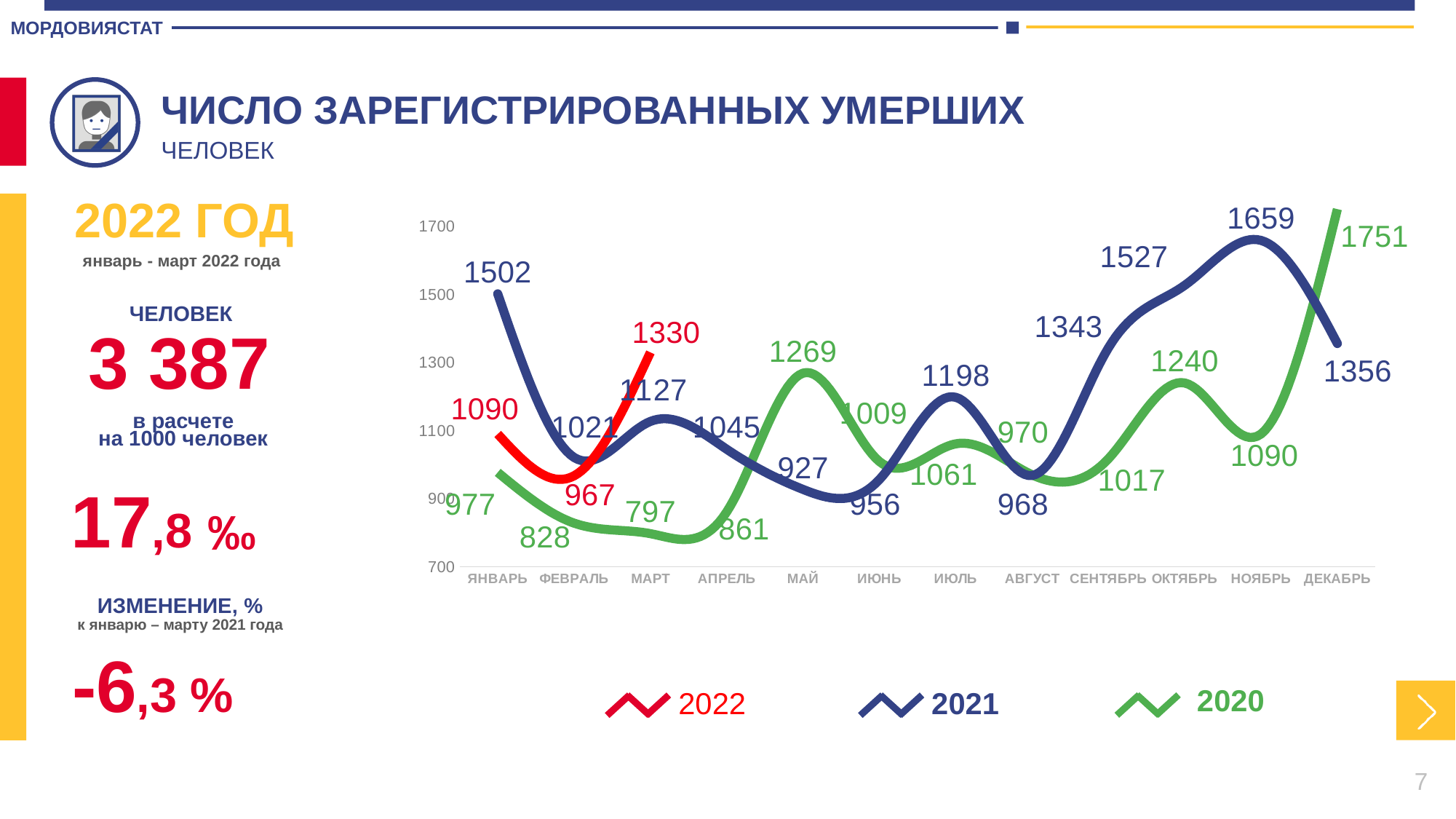
In which month does the 2021 series reach its highest value? НОЯБРЬ What is the value for March 2022 (МАРТ, 2022 series)? 1330 How many months are shown on the x axis of the chart? 12 In which month does the 2020 series have its lowest value? МАРТ How many series does the chart legend list? 3 Which series has the larger value in May (МАЙ): 2021 or 2020? 2020 What is the value for December 2020 (ДЕКАБРЬ, 2020 series)? 1751 What kind of chart is shown on the slide? line chart What is the difference between the 2021 values for November and December? 303 What is the number of registered deaths for January 2021 (ЯНВАРЬ, 2021 series)? 1502 In which month does the 2021 series have its lowest value? МАЙ What is the difference between the 2022 values for January and February? 123